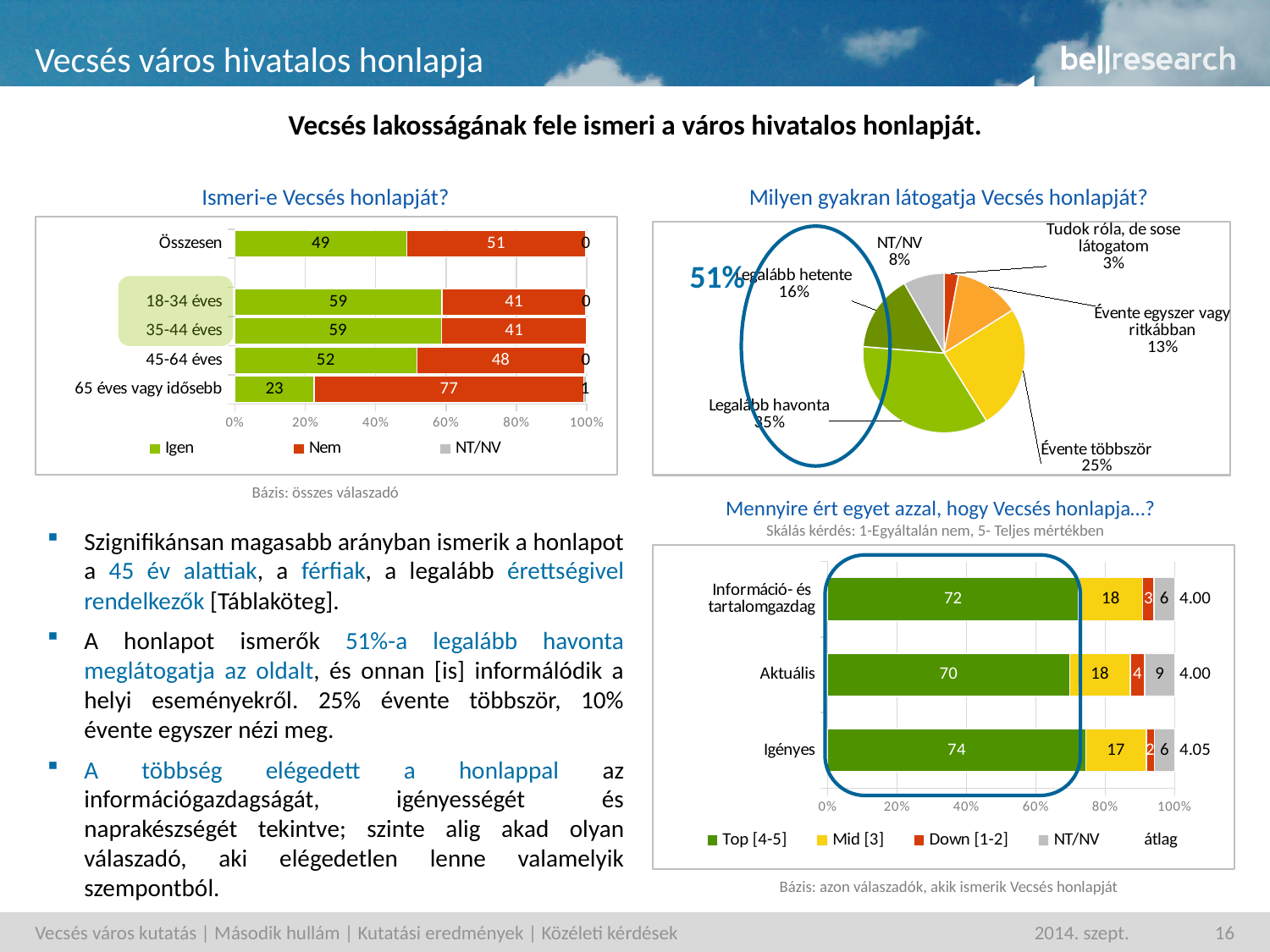
In the chart 'Mennyire ért egyet azzal, hogy Vecsés honlapja…?', what is the 'átlag' value for 'Igényes'? 4.05 In the chart 'Ismeri-e Vecsés honlapját?', what is the 'Igen' value for '65 éves vagy idősebb'? 23 In the chart 'Ismeri-e Vecsés honlapját?', which age group has the highest 'Nem' value? 65 éves vagy idősebb In the chart 'Ismeri-e Vecsés honlapját?', how many series does the legend list? 3 In the chart 'Ismeri-e Vecsés honlapját?', what is the 'Nem' value for 'Összesen'? 51 In the pie chart 'Milyen gyakran látogatja Vecsés honlapját?', which is larger: 'Évente többször' or 'Legalább hetente'? Évente többször In the pie chart 'Milyen gyakran látogatja Vecsés honlapját?', how many slices are there? 6 What type of chart is 'Mennyire ért egyet azzal, hogy Vecsés honlapja…?'? Stacked bar chart In the chart 'Mennyire ért egyet azzal, hogy Vecsés honlapja…?', what is the 'Top [4-5]' value for 'Igényes'? 74 In the chart 'Ismeri-e Vecsés honlapját?', what is the difference between the 'Igen' values for '18-34 éves' and '45-64 éves'? 7 In the pie chart 'Milyen gyakran látogatja Vecsés honlapját?', what is the share for 'Legalább havonta'? 35% In the pie chart 'Milyen gyakran látogatja Vecsés honlapját?', which slice is the smallest? Tudok róla, de sose látogatom